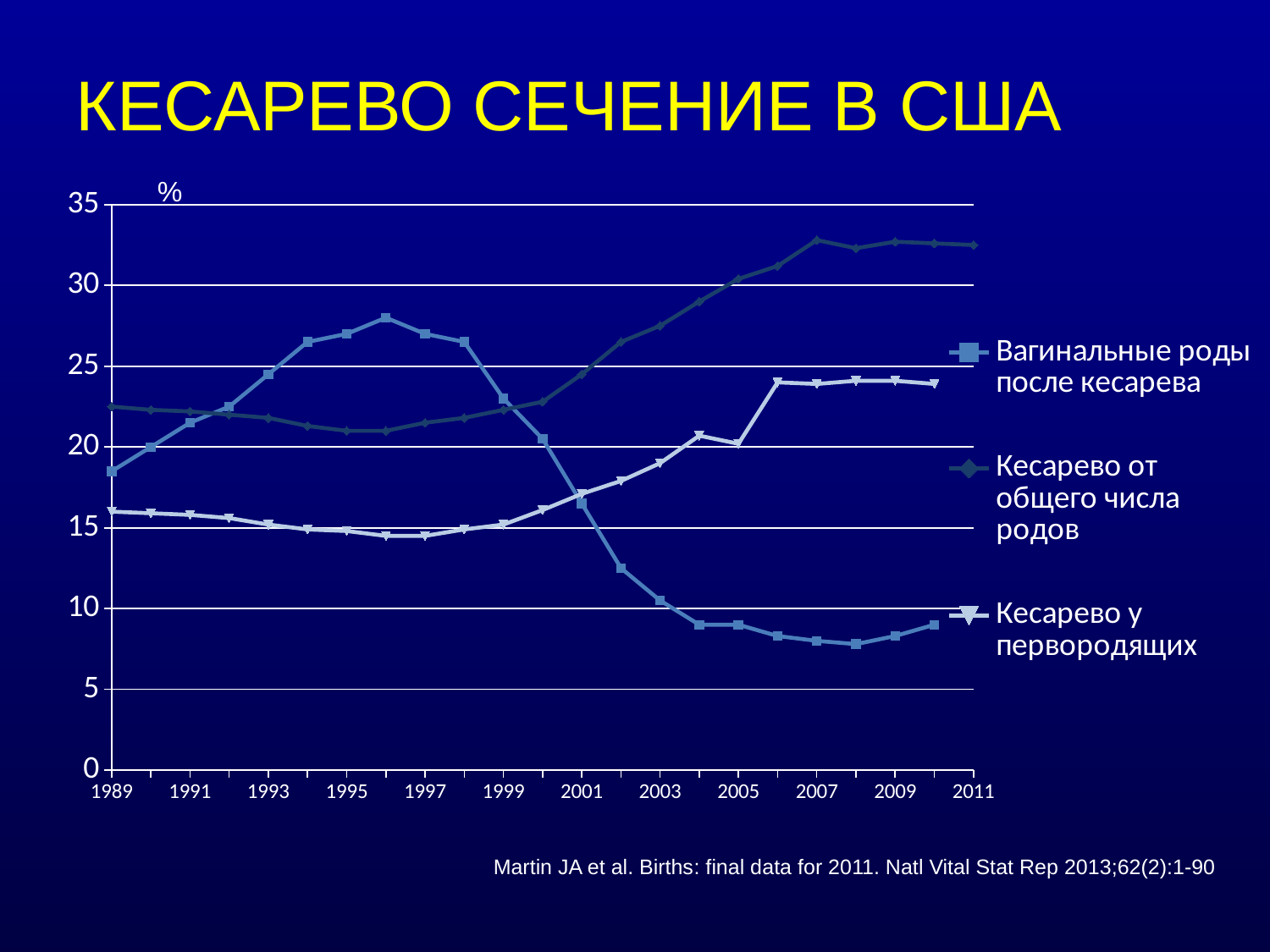
Is the value for Вагинальные роды после кесарева in 2008 greater or less than 10? less What kind of chart is shown on the slide? line chart Is the value for Вагинальные роды после кесарева in 1996 greater or less than 25? greater Is the value for Кесарево от общего числа родов in 2011 greater or less than 30? greater What unit is shown at the top of the vertical axis? % How many series does the legend list? 3 Which series has the lowest value in 2009? Вагинальные роды после кесарева What is the title of the chart? КЕСАРЕВО СЕЧЕНИЕ В США Does the Кесарево от общего числа родов series rise or fall between 2001 and 2007? rise Which series has the highest value in 2011? Кесарево от общего числа родов